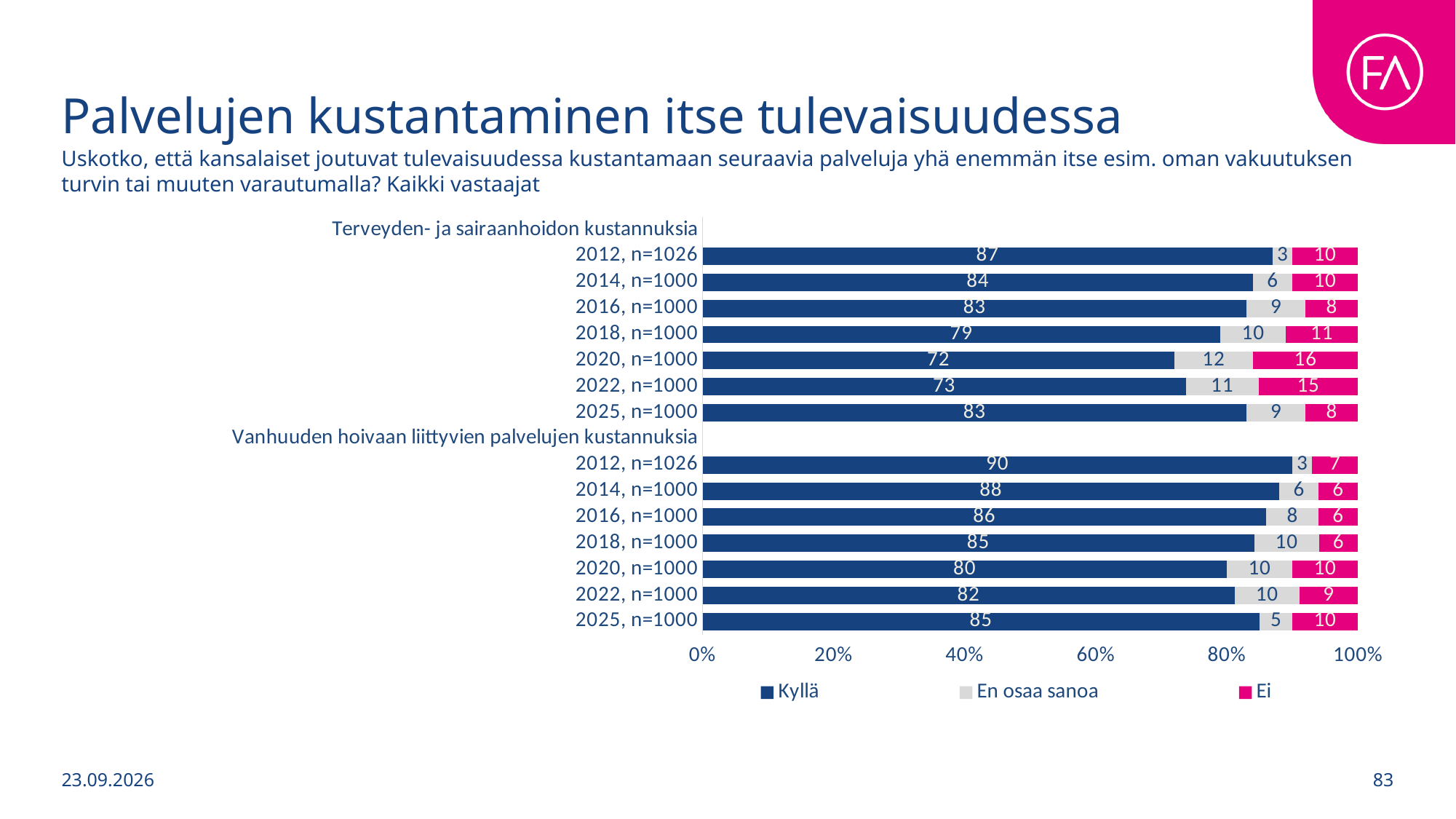
What is the difference between the "Kyllä" values for "Terveyden- ja sairaanhoidon kustannuksia" in 2012 and 2020? 15 What is the "Ei" value for "Vanhuuden hoivaan liittyvien palvelujen kustannuksia" in 2012, n=1026? 7 Which legend entry is shown in pink? Ei Which is larger: the "Ei" value for "Terveyden- ja sairaanhoidon kustannuksia" in 2020 or in 2025? 2020 Which year has the highest "Kyllä" value under "Vanhuuden hoivaan liittyvien palvelujen kustannuksia"? 2012, n=1026 What kind of chart is shown on the slide? Stacked bar chart Which year has the lowest "Kyllä" value under "Terveyden- ja sairaanhoidon kustannuksia"? 2020, n=1000 How many bars are shown under "Vanhuuden hoivaan liittyvien palvelujen kustannuksia"? 7 What is the "Kyllä" value for "Terveyden- ja sairaanhoidon kustannuksia" in 2020, n=1000? 72 How many series does the legend list? 3 What is the total of the stacked bar for "Vanhuuden hoivaan liittyvien palvelujen kustannuksia" in 2025, n=1000? 100 What is the "En osaa sanoa" value for "Terveyden- ja sairaanhoidon kustannuksia" in 2018, n=1000? 10